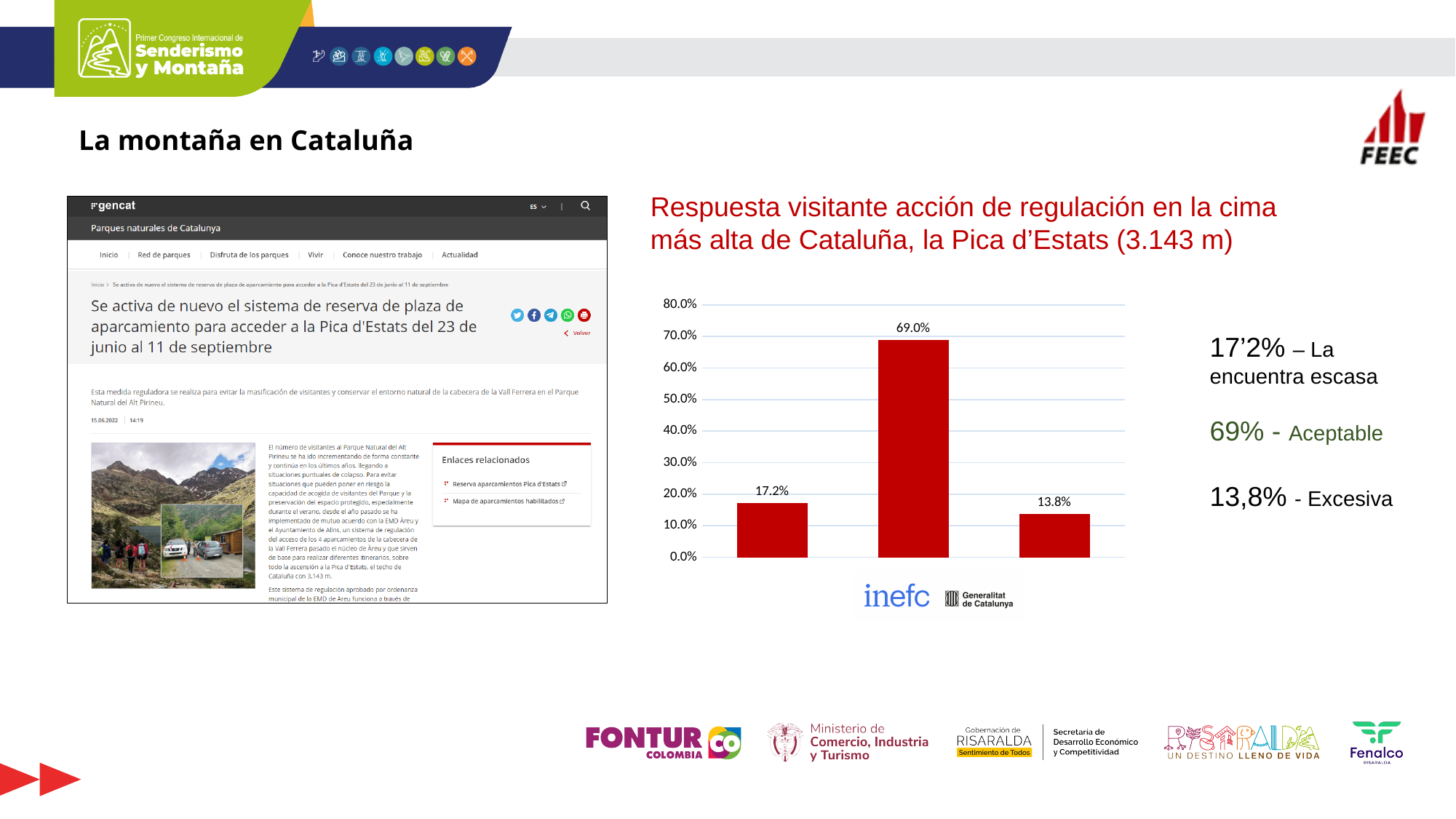
Which bar has the lowest value in the chart? the rightmost bar (13.8%) What type of chart is shown on the slide? bar chart What is the value shown on the middle (tallest) bar of the chart? 69.0% Which bar has the highest value in the chart? the middle bar (69.0%) What is the value shown on the first (leftmost) bar of the chart? 17.2% Which is larger, the leftmost bar or the rightmost bar? the leftmost bar What is the difference between the leftmost bar (17.2%) and the rightmost bar (13.8%)? 3.4% Is the value of the middle bar greater or less than 60.0%? greater How many bars are plotted in the chart? 3 What is the difference between the middle bar (69.0%) and the leftmost bar (17.2%)? 51.8% What is the value shown on the third (rightmost) bar of the chart? 13.8% What is the highest value shown on the chart's vertical axis? 80.0%